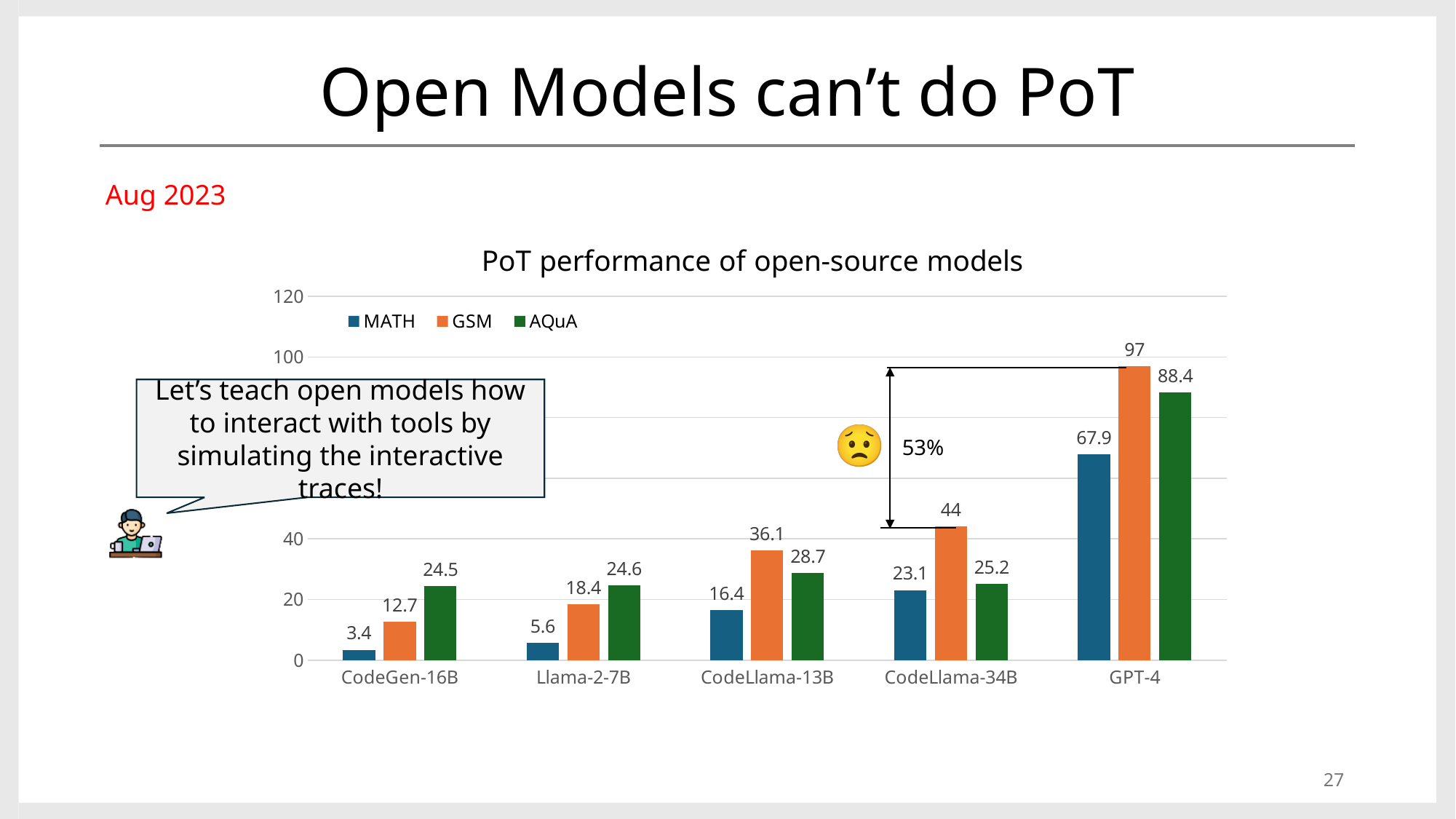
What kind of chart is shown? Bar chart What is the title of the chart? PoT performance of open-source models Which model has the highest MATH value? GPT-4 What is the GSM value for GPT-4? 97 Which is larger, the AQuA value for Llama-2-7B or the AQuA value for CodeGen-16B? Llama-2-7B How many series does the legend list? 3 Do the MATH values rise or fall from CodeGen-16B to GPT-4? Rise What is the MATH value for CodeGen-16B? 3.4 What is the AQuA value for CodeLlama-13B? 28.7 Which model has the lowest GSM value? CodeGen-16B What is the difference between the GSM values of GPT-4 and CodeLlama-34B? 53 How many models are shown on the x axis? 5